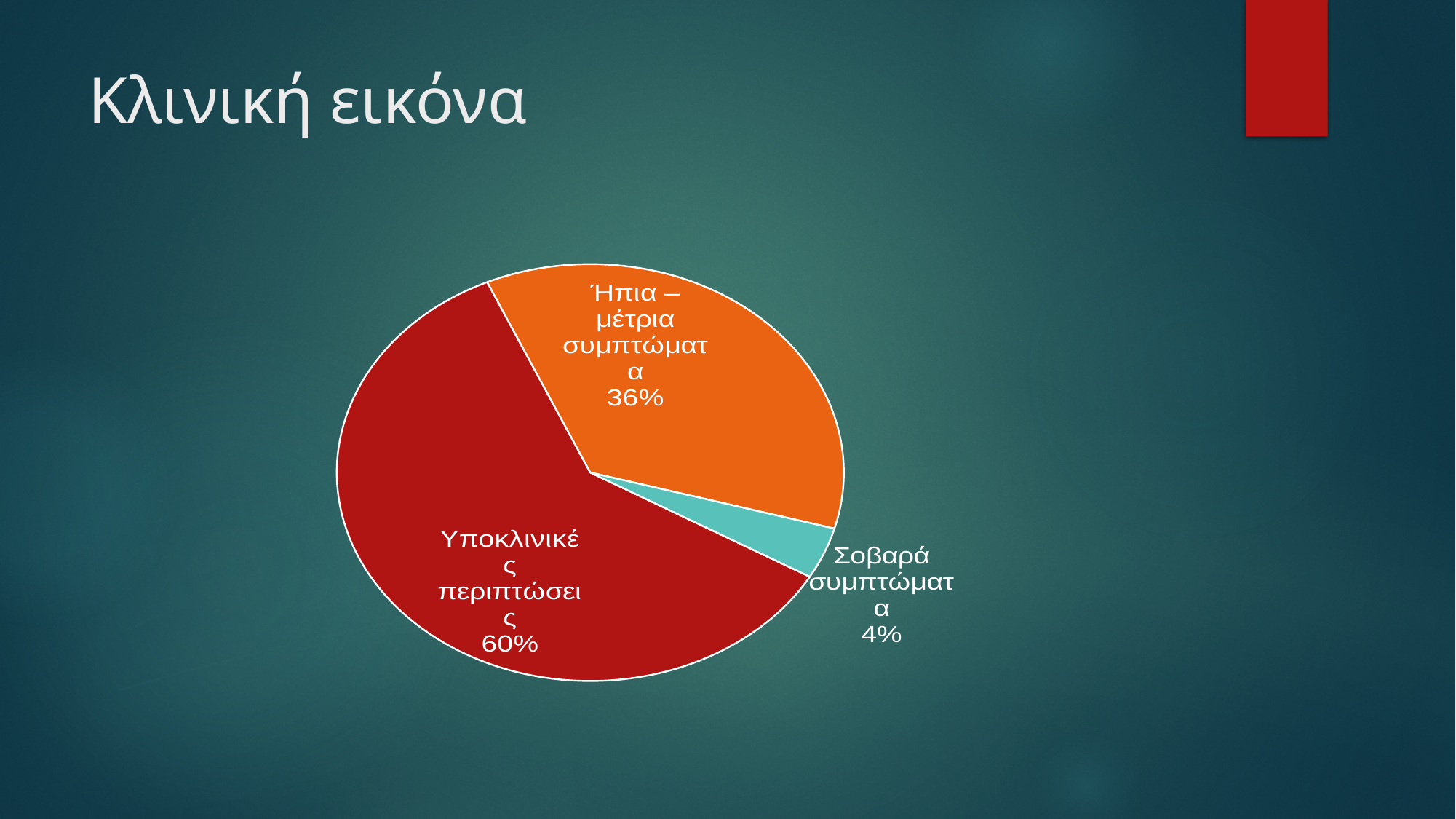
Which slice of the pie chart is the smallest? Σοβαρά συμπτώματα How many slices does the pie chart have? 3 What is the difference in percentage points between Ήπια – μέτρια συμπτώματα and Σοβαρά συμπτώματα? 32 What kind of chart is shown on the slide? Pie chart What colour is the slice for Σοβαρά συμπτώματα? Teal Which slice of the pie chart is the largest? Υποκλινικές περιπτώσεις What share of the pie is labelled Σοβαρά συμπτώματα? 4% Which is larger, the share for Ήπια – μέτρια συμπτώματα or the share for Σοβαρά συμπτώματα? Ήπια – μέτρια συμπτώματα What is the difference in percentage points between Υποκλινικές περιπτώσεις and Ήπια – μέτρια συμπτώματα? 24 What is the title of the slide containing the pie chart? Κλινική εικόνα What share of the pie is labelled Ήπια – μέτρια συμπτώματα? 36% What share of the pie is labelled Υποκλινικές περιπτώσεις? 60%